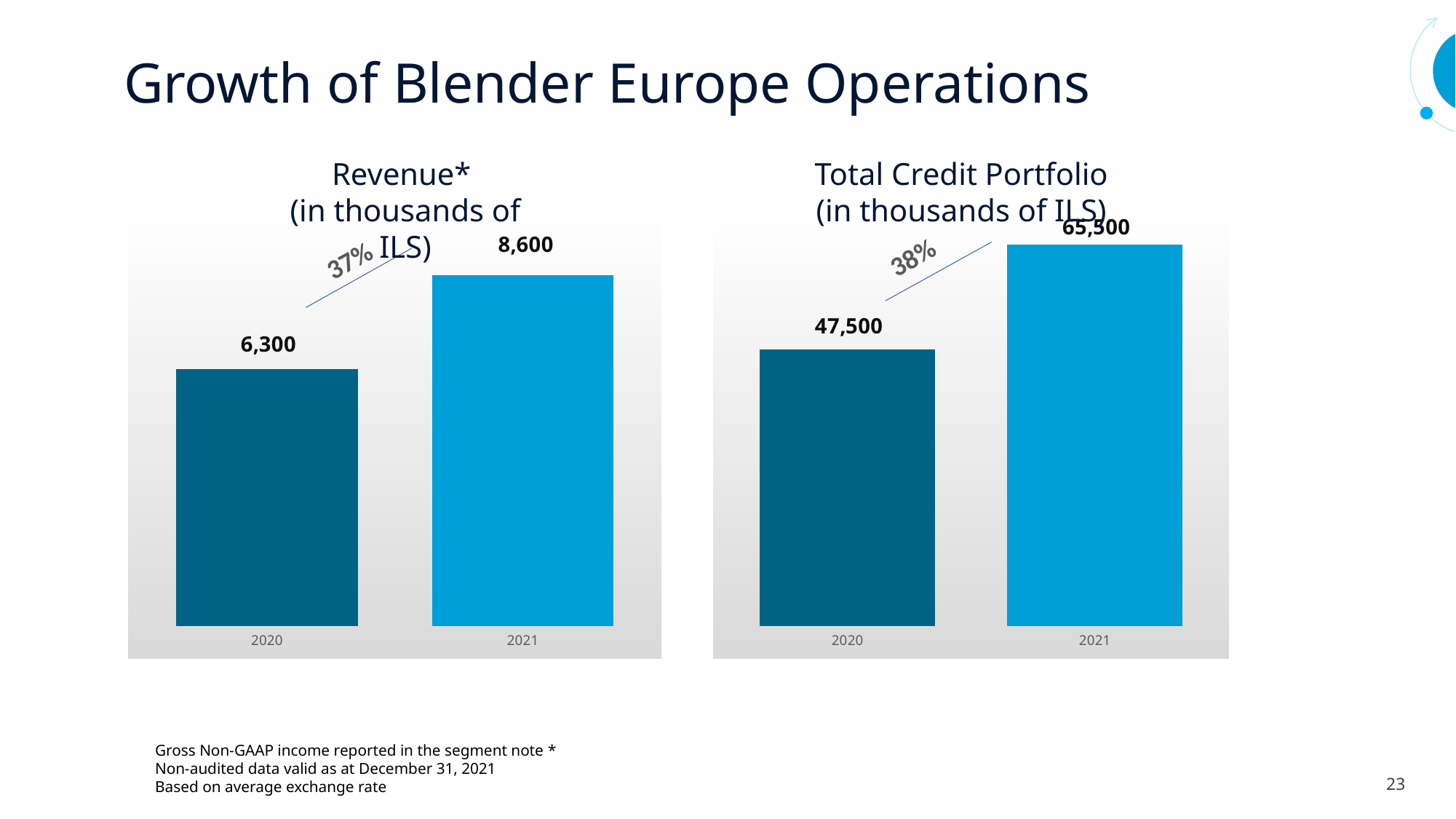
In the Total Credit Portfolio chart, what is the value for 2021? 65,500 In the Revenue chart, what is the difference between the 2021 and 2020 values? 2,300 In the Total Credit Portfolio chart, is the value for 2020 larger or smaller than the value for 2021? smaller What growth percentage is annotated on the Revenue chart between 2020 and 2021? 37% In the Revenue chart, what is the value for 2020? 6,300 How many bars are shown in the Revenue chart? 2 In the Revenue chart, what is the value for 2021? 8,600 In the Total Credit Portfolio chart, what is the difference between the 2021 and 2020 values? 18,000 In the Total Credit Portfolio chart, which year has the lower value? 2020 In the Total Credit Portfolio chart, what is the value for 2020? 47,500 What type of chart is the Total Credit Portfolio chart? bar chart In the Revenue chart, which year has the higher value? 2021